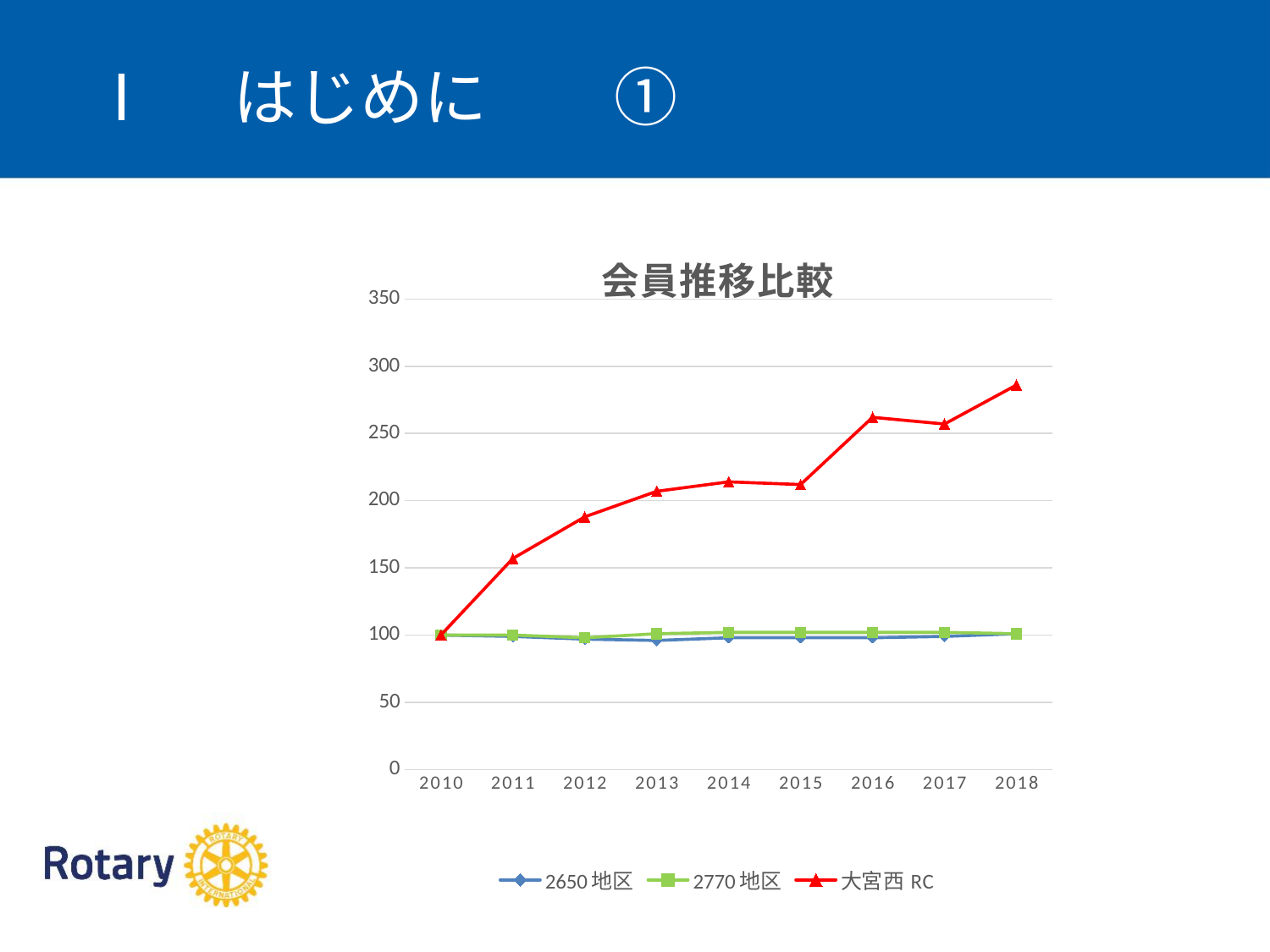
What is the title of the chart? 会員推移比較 Is the value for 大宮西 RC in 2018 greater or less than 250? greater Which series has the highest value in 2018? 大宮西 RC In which year is the value for 大宮西 RC lowest? 2010 What kind of chart is shown on the slide? line chart Which series is drawn in red? 大宮西 RC In which year is the value for 大宮西 RC highest? 2018 How many years are shown on the x axis? 9 How many series does the legend list? 3 Is the value for 大宮西 RC in 2012 greater or less than 150? greater Does the value for 大宮西 RC rise or fall from 2010 to 2018 overall? rise Which is larger in 2016, the value for 大宮西 RC or the value for 2770地区? 大宮西 RC